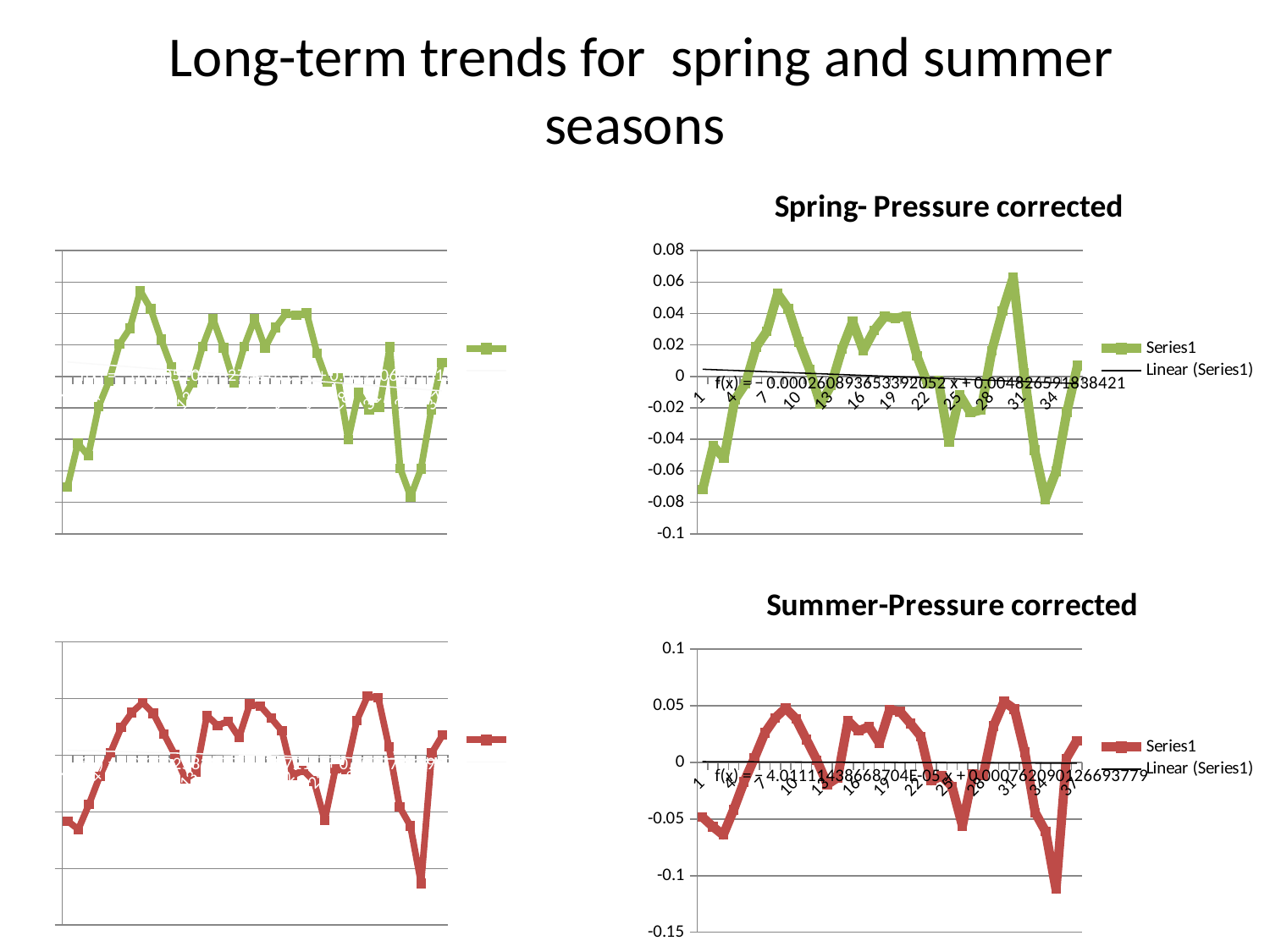
What are the two legend entries of the 'Spring- Pressure corrected' chart? Series1 and Linear (Series1) What is the title of the lower-right chart? Summer-Pressure corrected In the 'Summer-Pressure corrected' chart, is the value at x = 1 greater or less than 0? less How many series does the legend of the 'Summer-Pressure corrected' chart list? 2 In the 'Spring- Pressure corrected' chart, does the linear trendline rise or fall from left to right? fall In the 'Summer-Pressure corrected' chart, is the value at x = 34 greater or less than -0.1? greater In the 'Summer-Pressure corrected' chart, which is larger: the value at x = 10 or the value at x = 34? x = 10 In the 'Spring- Pressure corrected' chart, is the value at x = 31 greater or less than 0.04? less In the 'Spring- Pressure corrected' chart, which is larger: the value at x = 31 or the value at x = 1? x = 31 What kind of chart is the 'Spring- Pressure corrected' chart? line chart